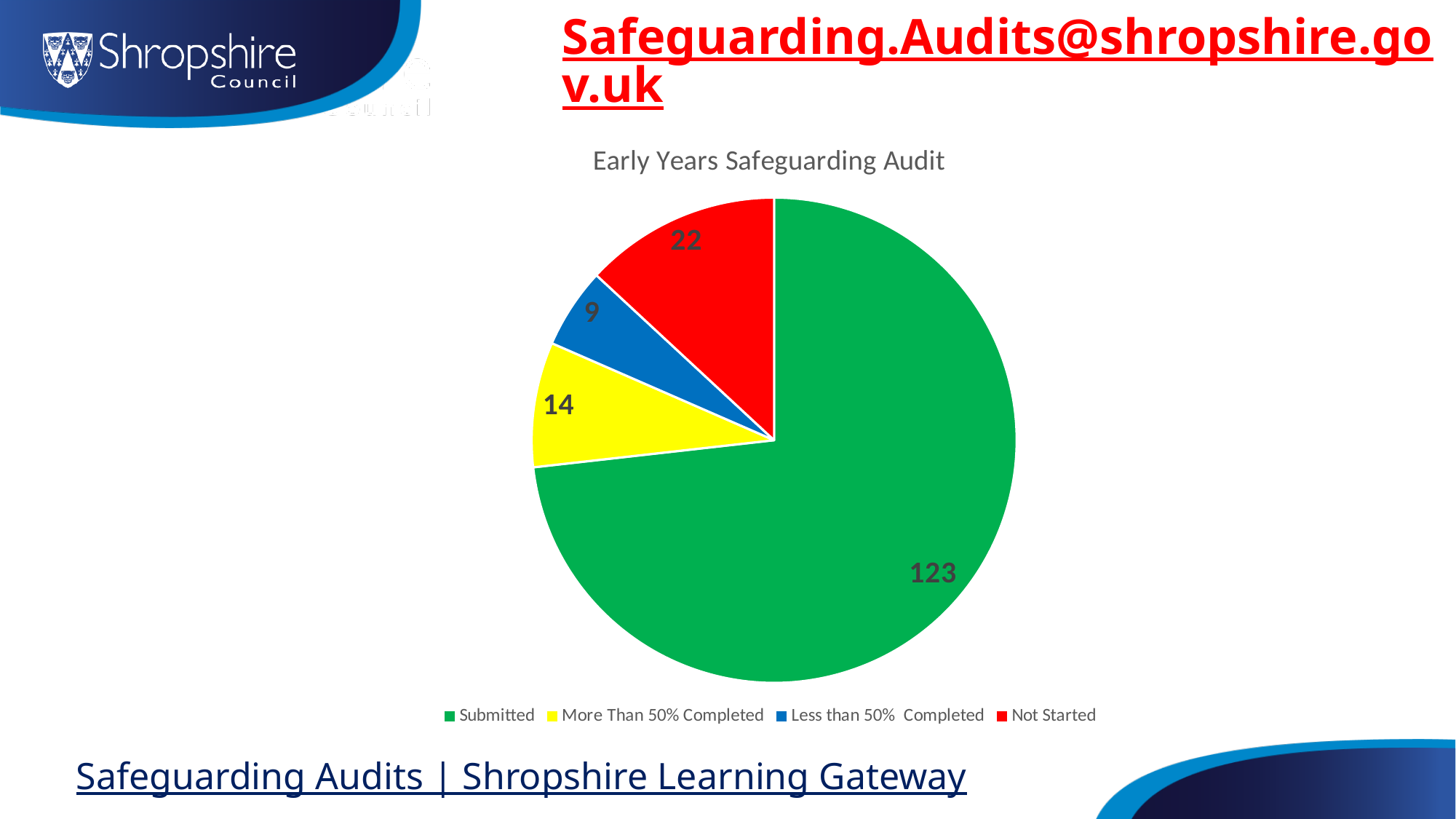
What is the difference between the Submitted value and the Not Started value? 101 What is the value for Less than 50% Completed in the pie chart? 9 What is the value for Submitted in the Early Years Safeguarding Audit pie chart? 123 Which is larger, Not Started or More Than 50% Completed? Not Started How many categories are shown in the Early Years Safeguarding Audit pie chart? 4 What is the value for More Than 50% Completed in the pie chart? 14 What is the total of all slices in the Early Years Safeguarding Audit pie chart? 168 Which category has the smallest slice in the Early Years Safeguarding Audit pie chart? Less than 50% Completed Which category has the largest slice in the Early Years Safeguarding Audit pie chart? Submitted What is the value for Not Started in the Early Years Safeguarding Audit pie chart? 22 What colour is the Not Started slice in the pie chart? Red What type of chart is shown on the slide? Pie chart